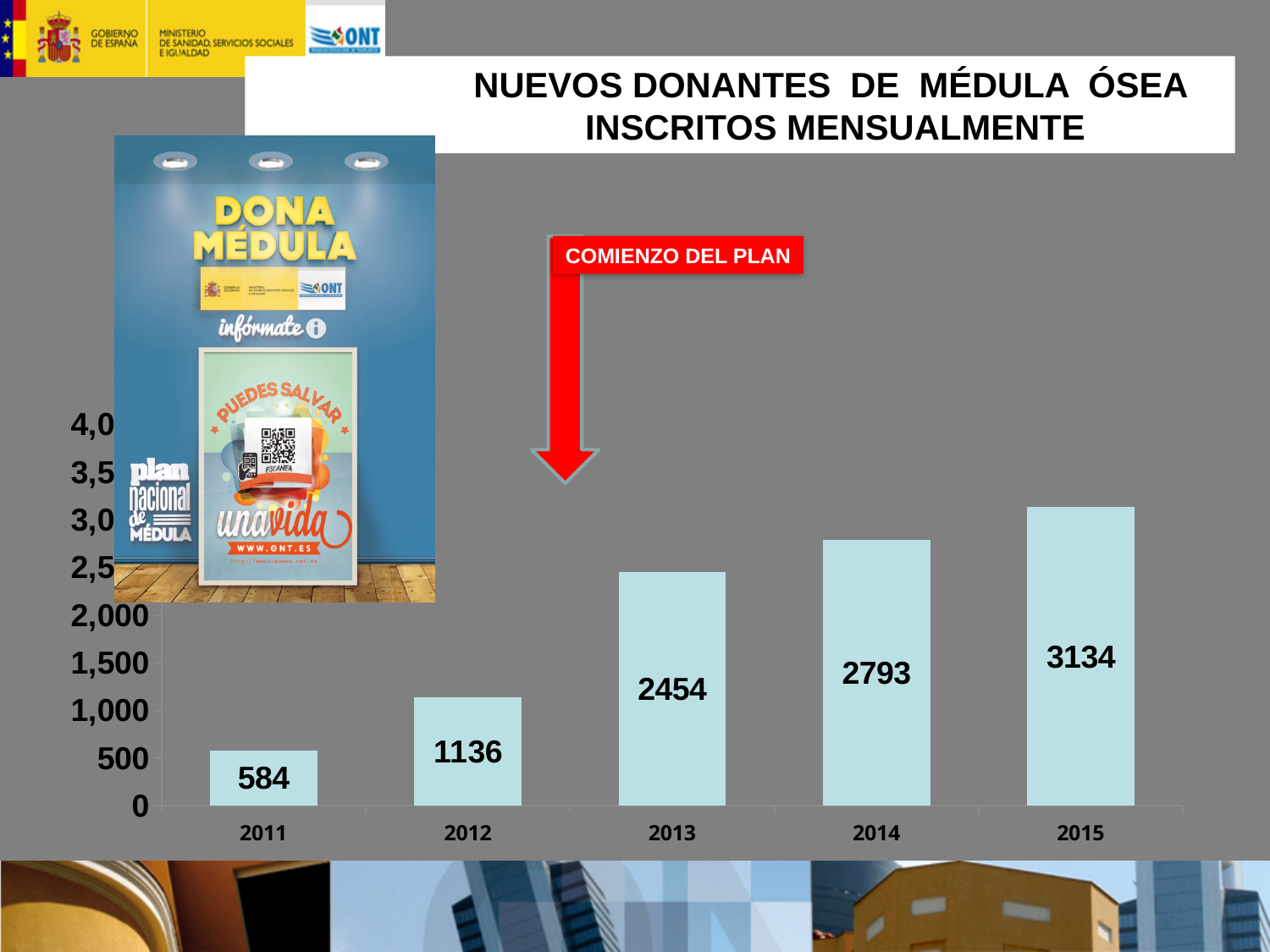
What is the difference between the values for 2015 and 2014? 341 What kind of chart is shown on the slide? bar chart What is the value for 2015? 3134 Which year has the lowest value? 2011 Do the values rise or fall from 2011 to 2015? rise What is the difference between the values for 2013 and 2012? 1318 Which is larger, the value for 2012 or the value for 2014? 2014 How many years are shown on the x axis? 5 What is the value for 2011? 584 Which year has the highest value? 2015 Is the value for 2013 greater or less than 2,000? greater What is the value for 2013? 2454